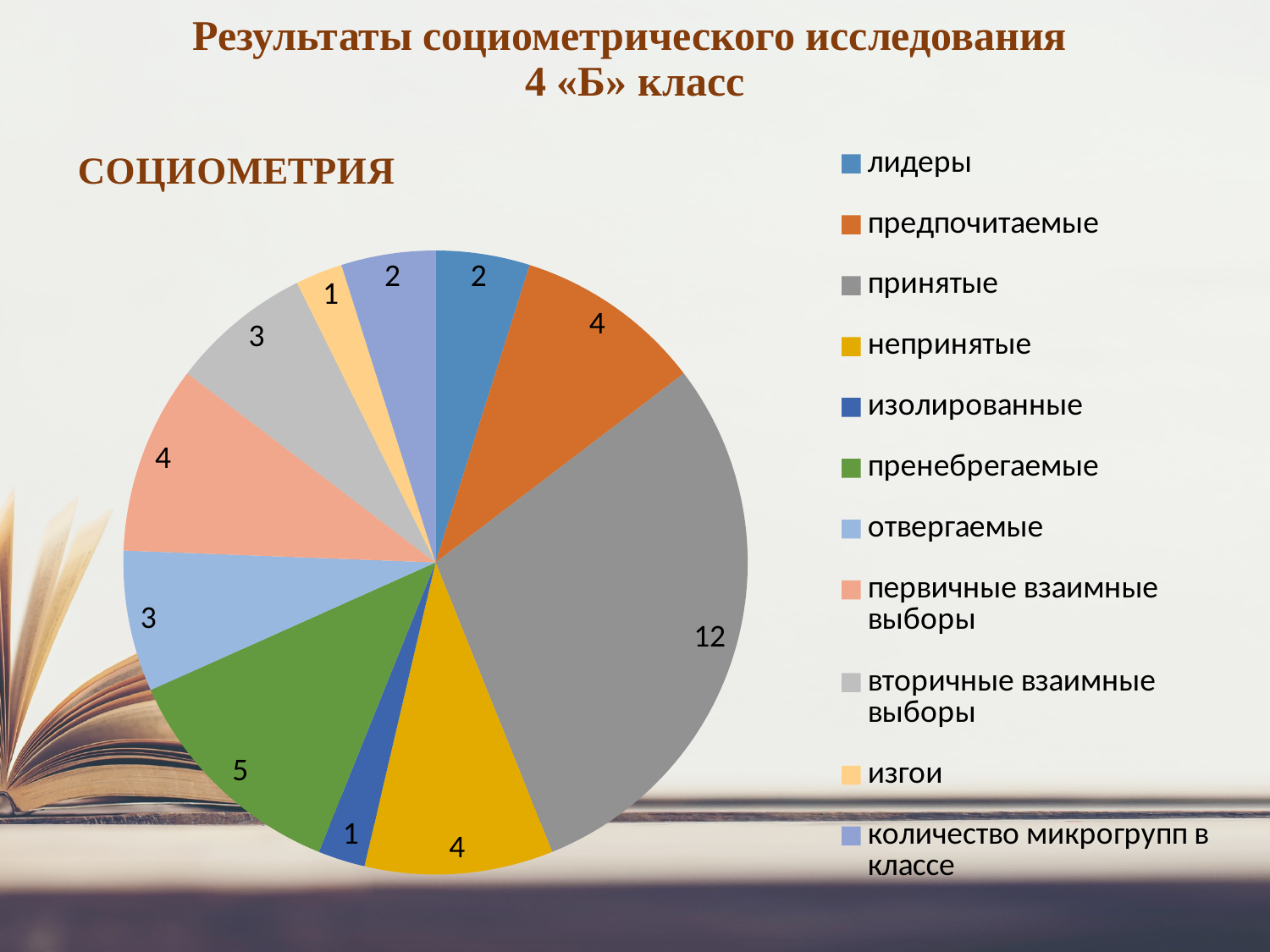
What is the value for изолированные? 1 What is the value for лидеры? 2 What is the value for пренебрегаемые? 5 What is the sum of all the values shown on the pie chart? 41 Which is larger, the value for отвергаемые or the value for непринятые? непринятые What is the value for первичные взаимные выборы? 4 What kind of chart is shown on the slide? pie chart How many slices does the pie chart have? 11 What is the title of the chart? СОЦИОМЕТРИЯ What is the difference between the values for принятые and пренебрегаемые? 7 What is the value for принятые? 12 Which category has the largest slice of the pie? принятые